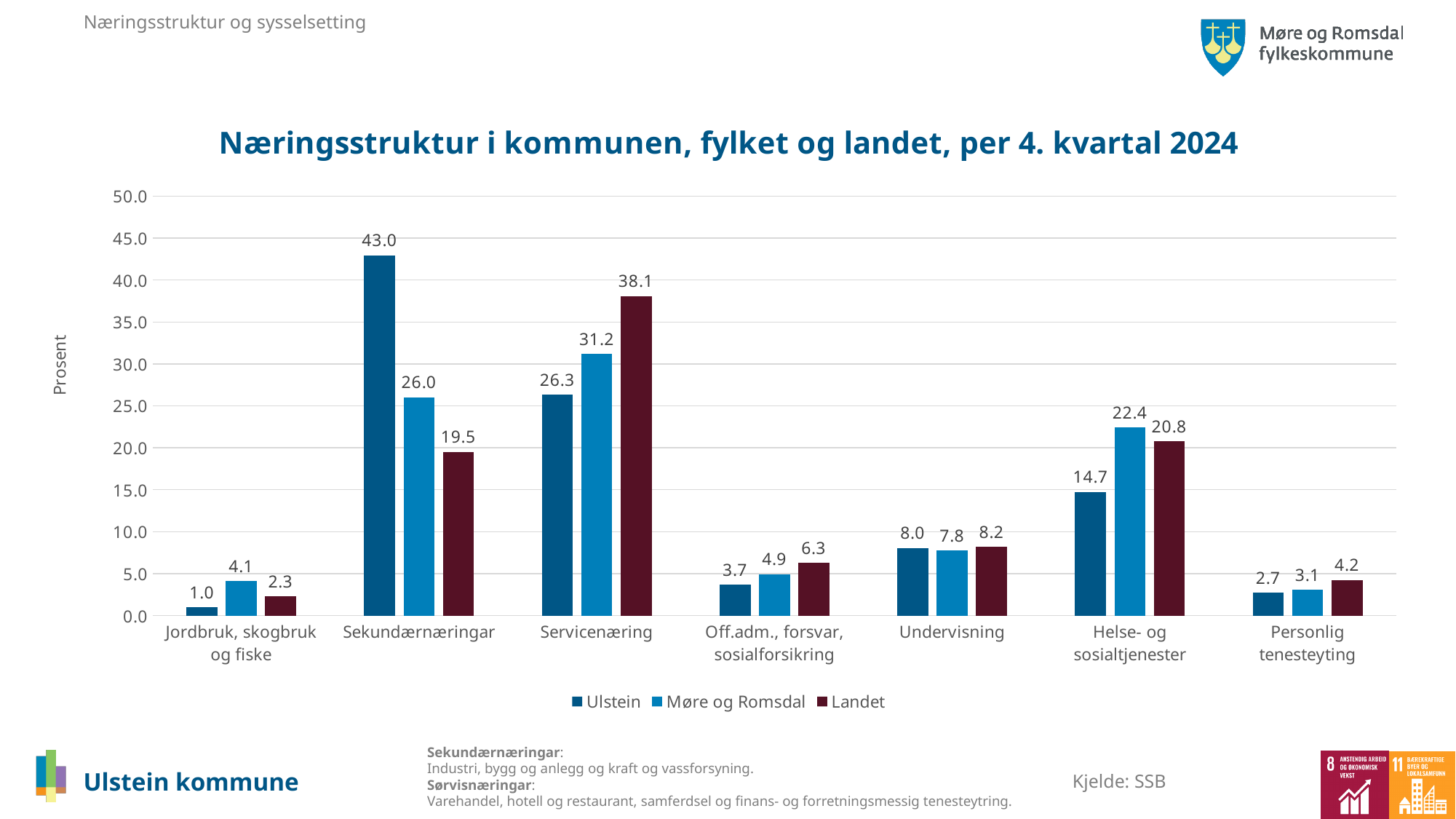
What is the title of the chart? Næringsstruktur i kommunen, fylket og landet, per 4. kvartal 2024 How many series does the legend list? 3 Is the value for Landet in Helse- og sosialtjenester greater or less than 25.0? less Which is larger in Servicenæring: the value for Ulstein or for Møre og Romsdal? Møre og Romsdal What is the value for Landet in Servicenæring? 38.1 What kind of chart is shown on the slide? Bar chart Which category has the highest value for Ulstein? Sekundærnæringar How many categories are shown on the x axis? 7 Which category has the lowest value for Ulstein? Jordbruk, skogbruk og fiske What is the difference between the Ulstein and Landet values in Sekundærnæringar? 23.5 What is the value for Møre og Romsdal in Helse- og sosialtjenester? 22.4 What is the value for Ulstein in Sekundærnæringar? 43.0